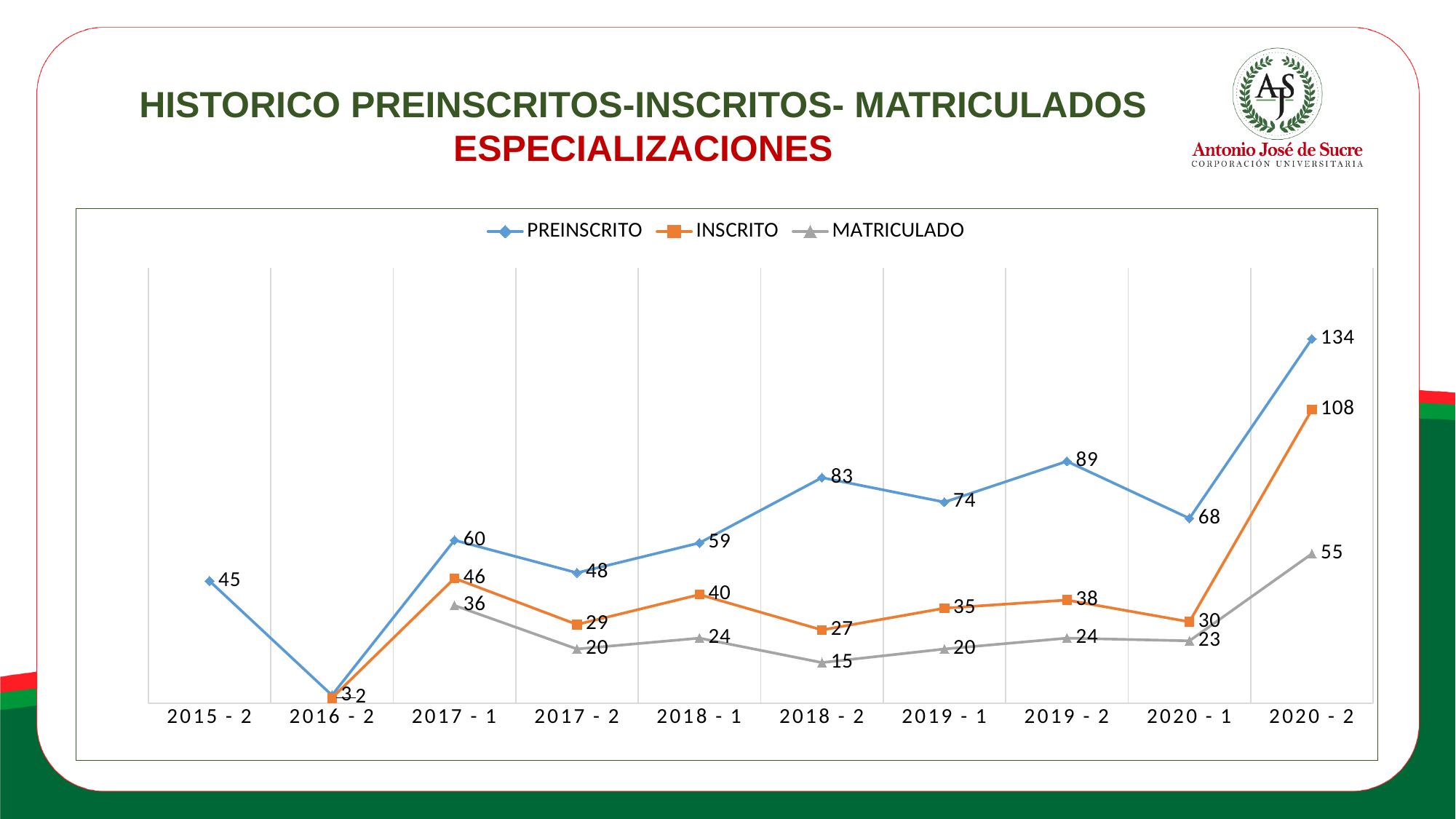
Does the PREINSCRITO value rise or fall from 2019 - 2 to 2020 - 1? Fall In which period is the PREINSCRITO value highest? 2020 - 2 In which period is the MATRICULADO value lowest? 2018 - 2 Which is larger for PREINSCRITO: the value in 2018 - 2 or in 2019 - 1? 2018 - 2 How many series does the legend list? 3 What is the difference between the PREINSCRITO and INSCRITO values in 2020 - 2? 26 What is the PREINSCRITO value for 2020 - 2? 134 How many periods are shown on the x axis? 10 What is the MATRICULADO value for 2018 - 2? 15 What kind of chart is shown on the slide? Line chart What is the INSCRITO value for 2017 - 1? 46 What is the INSCRITO value for 2019 - 2? 38